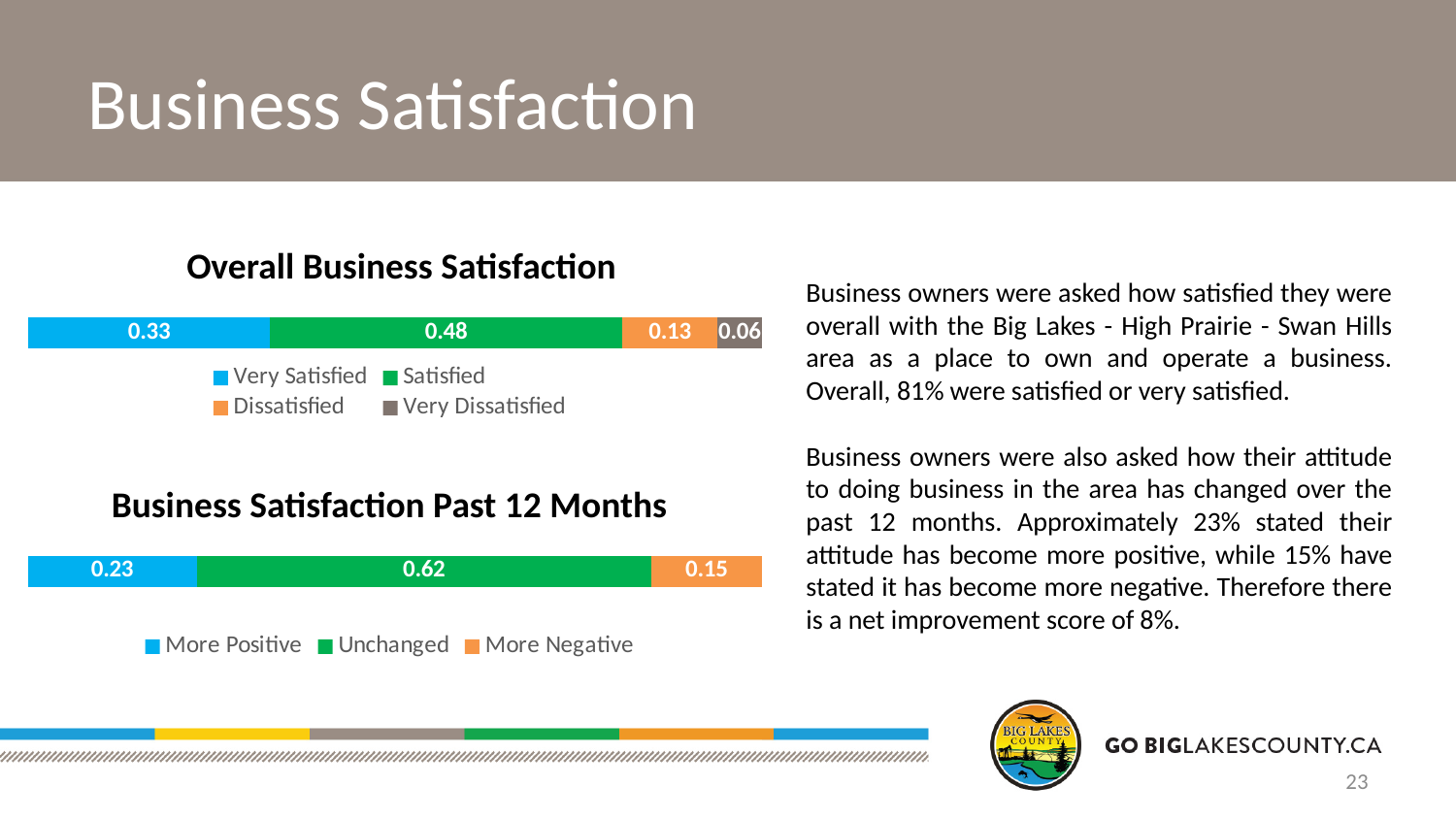
In the 'Business Satisfaction Past 12 Months' chart, what is the value for Unchanged? 0.62 In the 'Overall Business Satisfaction' chart, what is the difference between the Satisfied and Very Satisfied values? 0.15 In the 'Business Satisfaction Past 12 Months' chart, what is the value for More Negative? 0.15 In the 'Overall Business Satisfaction' chart, what is the value for Very Dissatisfied? 0.06 In the 'Overall Business Satisfaction' chart, what is the value for Satisfied? 0.48 In the 'Overall Business Satisfaction' chart, how many series does the legend list? 4 In the 'Business Satisfaction Past 12 Months' chart, which is larger, More Positive or More Negative? More Positive In the 'Business Satisfaction Past 12 Months' chart, what is the difference between More Positive and More Negative? 0.08 What kind of chart is the 'Overall Business Satisfaction' chart? Stacked bar chart In the 'Overall Business Satisfaction' chart, which category has the smallest value? Very Dissatisfied In the 'Overall Business Satisfaction' chart, which category has the largest value? Satisfied In the 'Business Satisfaction Past 12 Months' chart, how many series does the legend list? 3